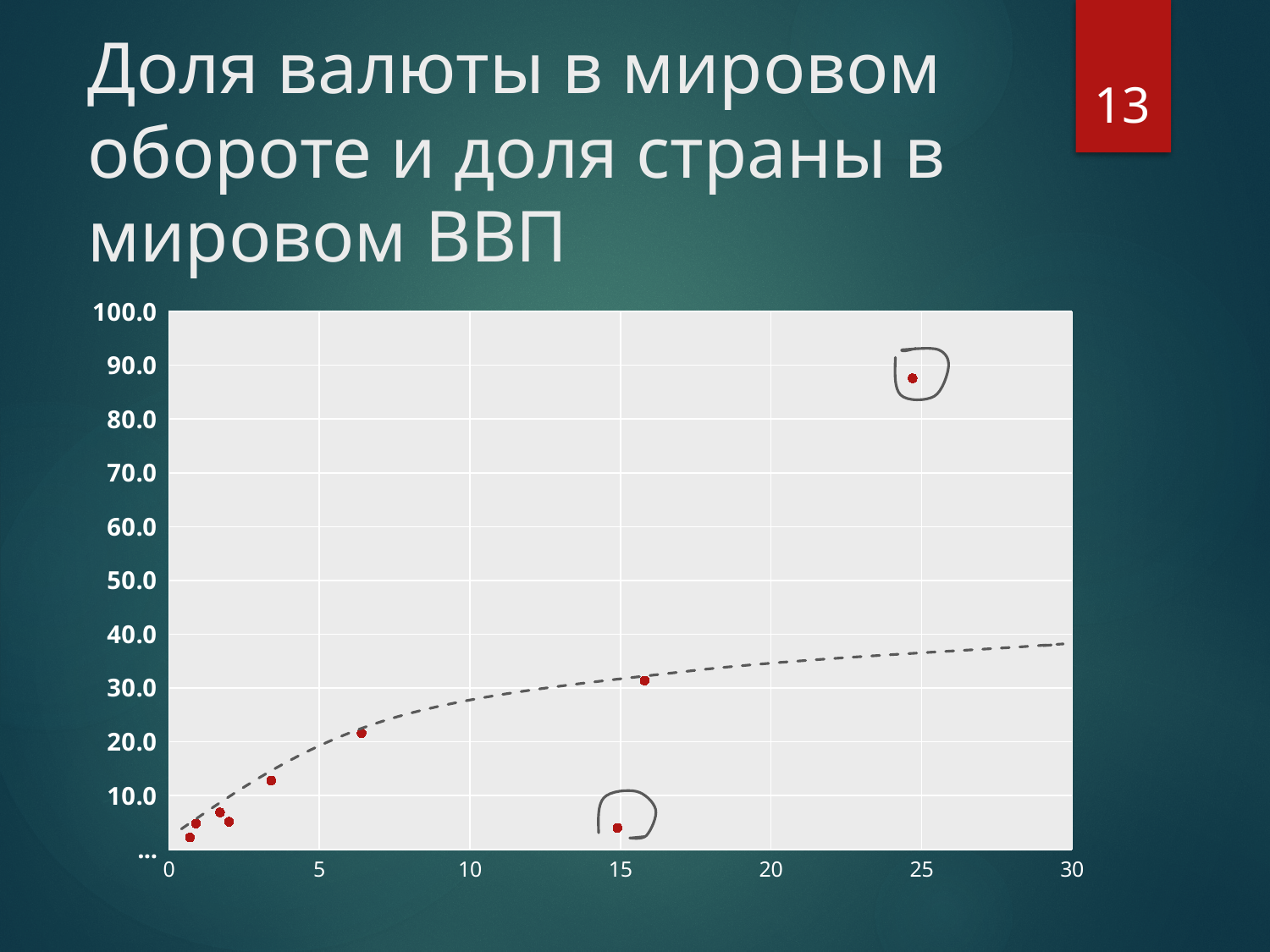
What is the title of the chart on the slide? Доля валюты в мировом обороте и доля страны в мировом ВВП Is the value of the point plotted near x = 16 greater or less than 40? less What is the highest value shown on the horizontal axis of the chart? 30 Is the value of the point plotted near x = 3.5 greater or less than 10? greater Does the dashed trend line rise or fall as the x value increases? rises What is the highest value shown on the vertical axis of the chart? 100.0 Which point has the highest value on the chart: the one near x = 25 or the one near x = 16? the one near x = 25 Is the value of the point plotted near x = 6.5 greater or less than 30? less What kind of chart is shown on the slide? scatter chart How many points on the chart are circled by hand? 2